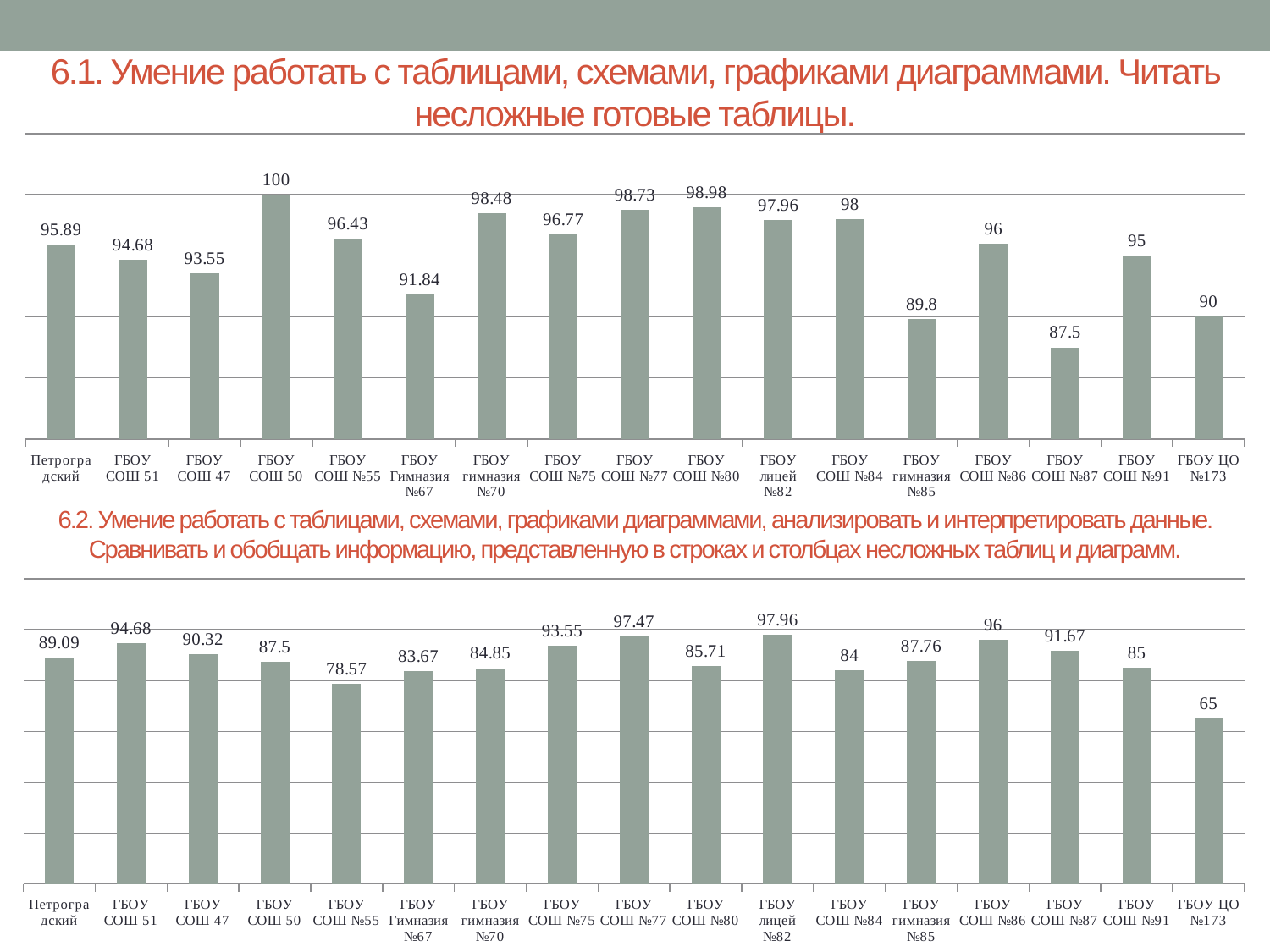
In the bottom chart (6.2), what is the value for ГБОУ ЦО №173? 65 In the top chart (6.1), which is larger: ГБОУ СОШ №80 or ГБОУ лицей №82? ГБОУ СОШ №80 How many categories are shown in the top chart (6.1)? 17 In the top chart (6.1), what is the value for ГБОУ СОШ 50? 100 In the top chart (6.1), what is the difference between ГБОУ СОШ 50 and ГБОУ СОШ №87? 12.5 In the bottom chart (6.2), which category has the highest value? ГБОУ лицей №82 In the bottom chart (6.2), what is the difference between ГБОУ СОШ №86 and ГБОУ СОШ №84? 12 In the bottom chart (6.2), which category has the lowest value? ГБОУ ЦО №173 In the top chart (6.1), which category has the lowest value? ГБОУ СОШ №87 In the bottom chart (6.2), what is the value for ГБОУ СОШ №55? 78.57 What type of chart is the bottom chart (6.2)? Bar chart In the top chart (6.1), what is the value for ГБОУ гимназия №85? 89.8